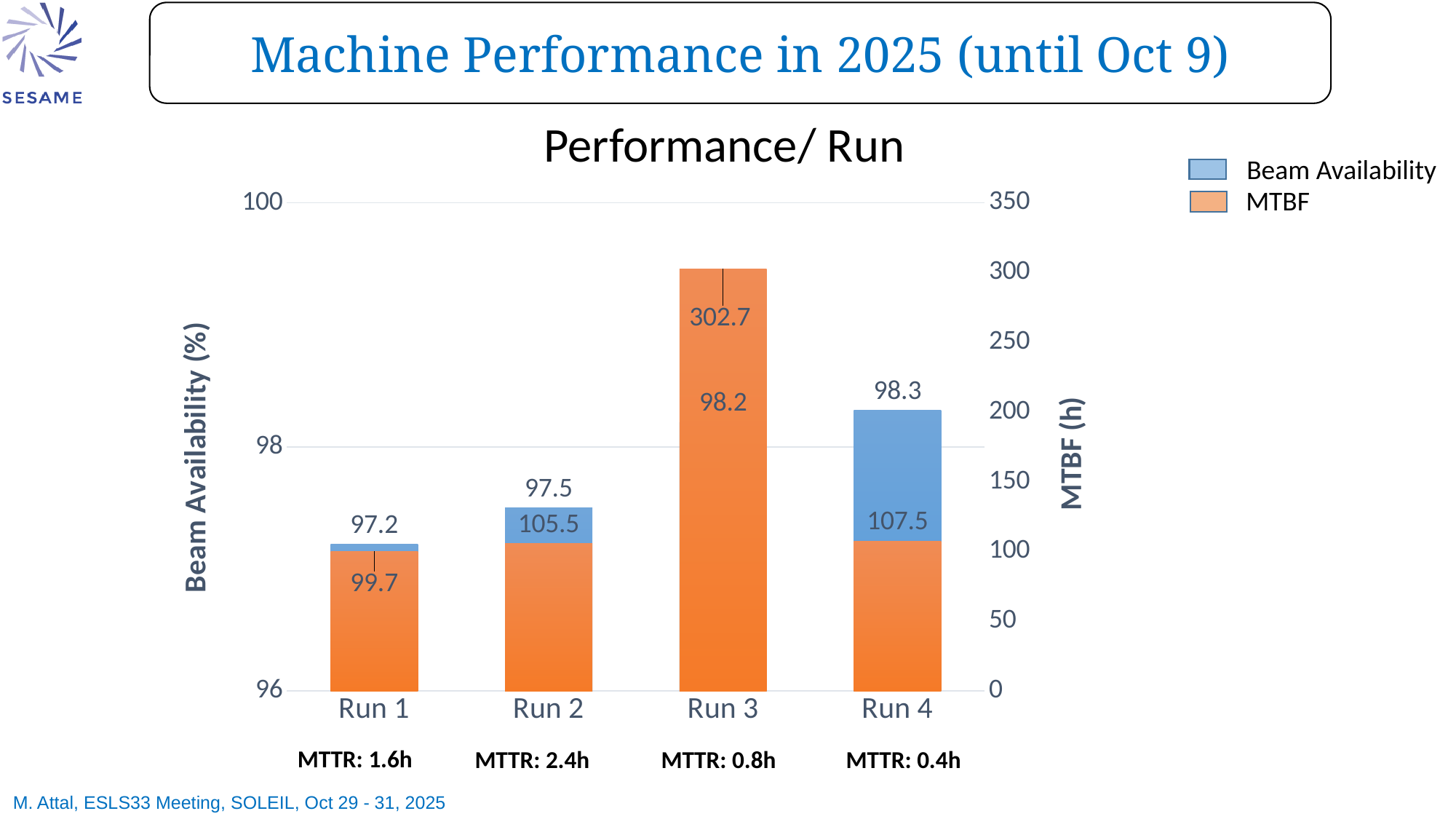
What is the difference in MTBF between Run 3 and Run 1? 203.0 What is the difference in Beam Availability between Run 4 and Run 1? 1.1 Which run has the lowest Beam Availability? Run 1 How many runs are shown on the x axis? 4 What is the Beam Availability for Run 3? 98.2 What is the MTBF for Run 2? 105.5 How many series does the legend list? 2 What is the MTTR shown for Run 4? 0.4h Which run has the highest MTBF? Run 3 Which has a higher MTBF, Run 2 or Run 4? Run 4 What is the MTBF for Run 4? 107.5 What kind of chart is shown? Bar chart